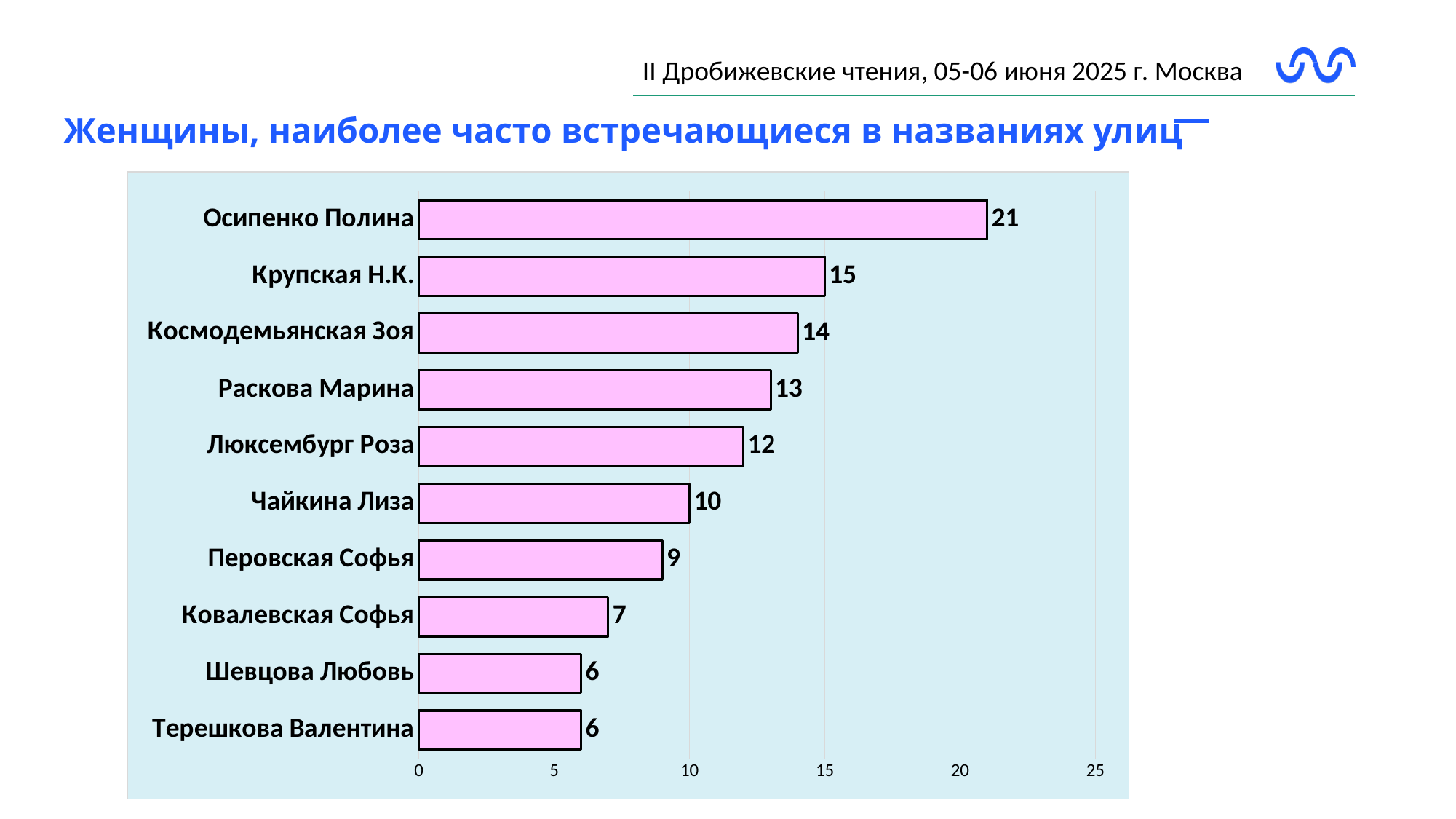
What is the difference between the values for Осипенко Полина and Крупская Н.К.? 6 What is the value for Осипенко Полина? 21 Which is larger, the value for Космодемьянская Зоя or the value for Перовская Софья? Космодемьянская Зоя What is the value for Люксембург Роза? 12 Which category has the highest value? Осипенко Полина What is the title of the slide? Женщины, наиболее часто встречающиеся в названиях улиц What is the difference between the values for Чайкина Лиза and Шевцова Любовь? 4 What is the highest tick value shown on the horizontal axis? 25 Is the value for Раскова Марина greater or less than 10? greater What is the value for Ковалевская Софья? 7 What kind of chart is shown on the slide? bar chart How many categories are shown in the chart? 10